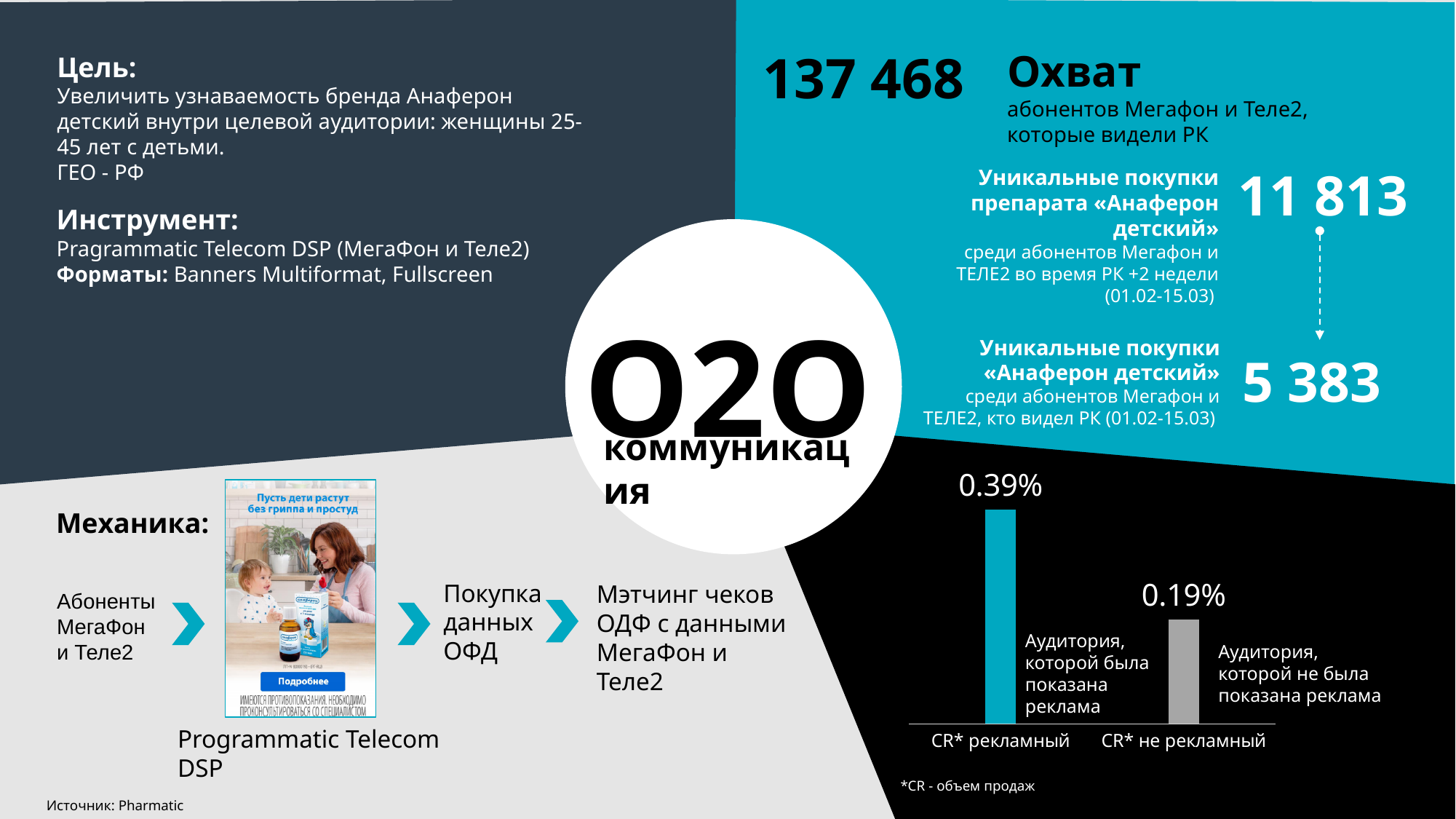
Do the values in the bar chart rise or fall from left to right? Fall What is the difference between the CR* рекламный and CR* не рекламный values in the bar chart? 0.20% What is the value for CR* рекламный in the bar chart? 0.39% Which category in the bar chart has the lowest value? CR* не рекламный According to the footnote under the bar chart, what does CR stand for? Объем продаж Which category in the bar chart has the highest value? CR* рекламный What is the value for CR* не рекламный in the bar chart? 0.19% What kind of chart is shown at the bottom right of the slide? Bar chart What colour is the bar for CR* рекламный in the bar chart? Teal (blue) Which is larger in the bar chart: CR* рекламный or CR* не рекламный? CR* рекламный How many bars are shown in the bar chart? 2